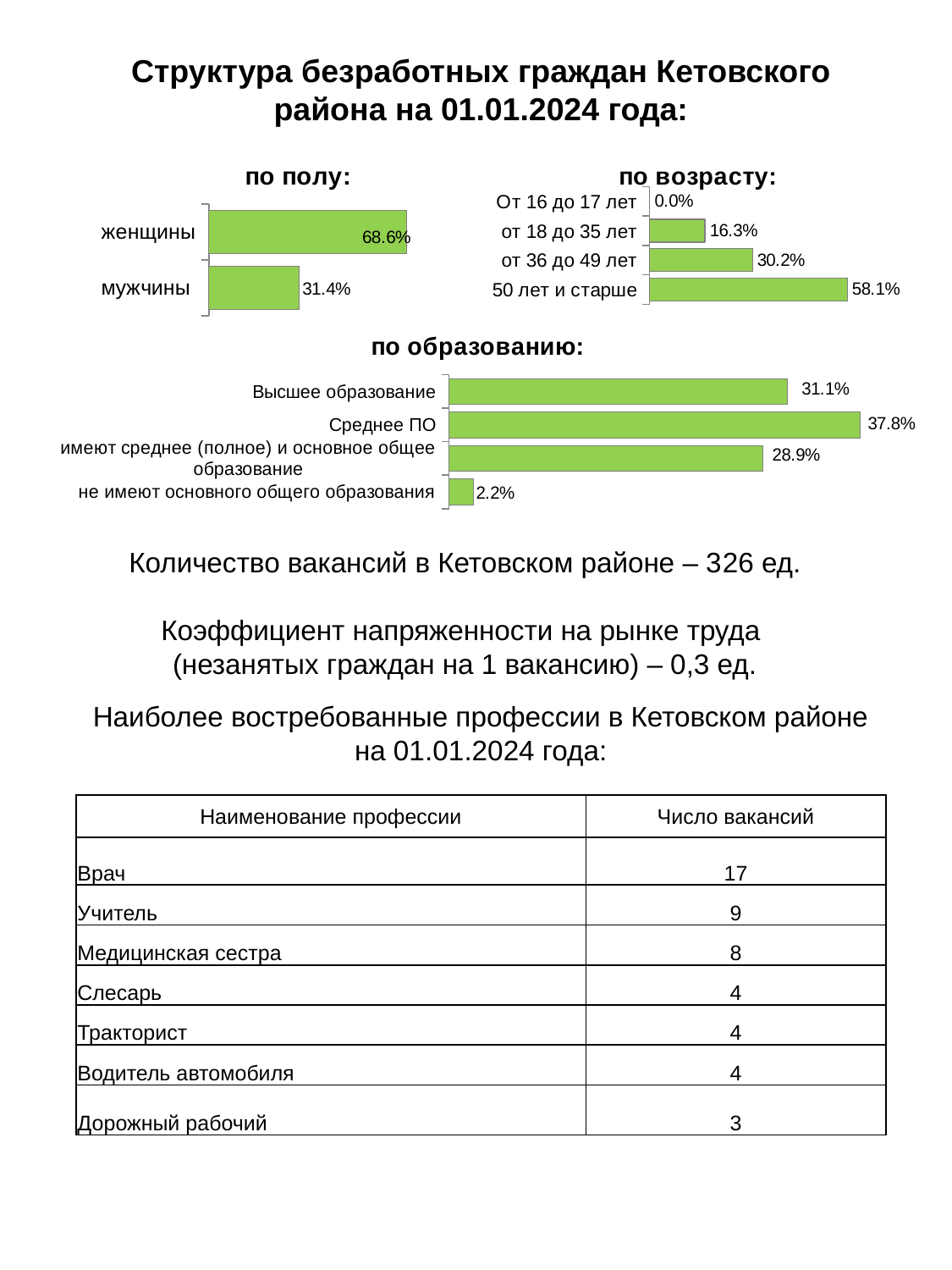
In the chart titled "по образованию:", which category has the highest value? Среднее ПО In the chart titled "по образованию:", which is larger: the value for Высшее образование or the value for имеют среднее (полное) и основное общее образование? Высшее образование In the chart titled "по полу:", what is the difference between the values for женщины and мужчины? 37.2% What type of chart is the chart titled "по полу:"? bar chart In the chart titled "по возрасту:", what is the value for От 16 до 17 лет? 0.0% In the chart titled "по образованию:", what is the value for Высшее образование? 31.1% In the chart titled "по возрасту:", how many age categories are shown? 4 In the chart titled "по возрасту:", which age group has the highest value? 50 лет и старше In the chart titled "по полу:", what is the value for женщины? 68.6% In the chart titled "по образованию:", which category has the lowest value? не имеют основного общего образования In the chart titled "по возрасту:", what is the value for от 18 до 35 лет? 16.3% In the chart titled "по возрасту:", what is the difference between the values for 50 лет и старше and от 36 до 49 лет? 27.9%